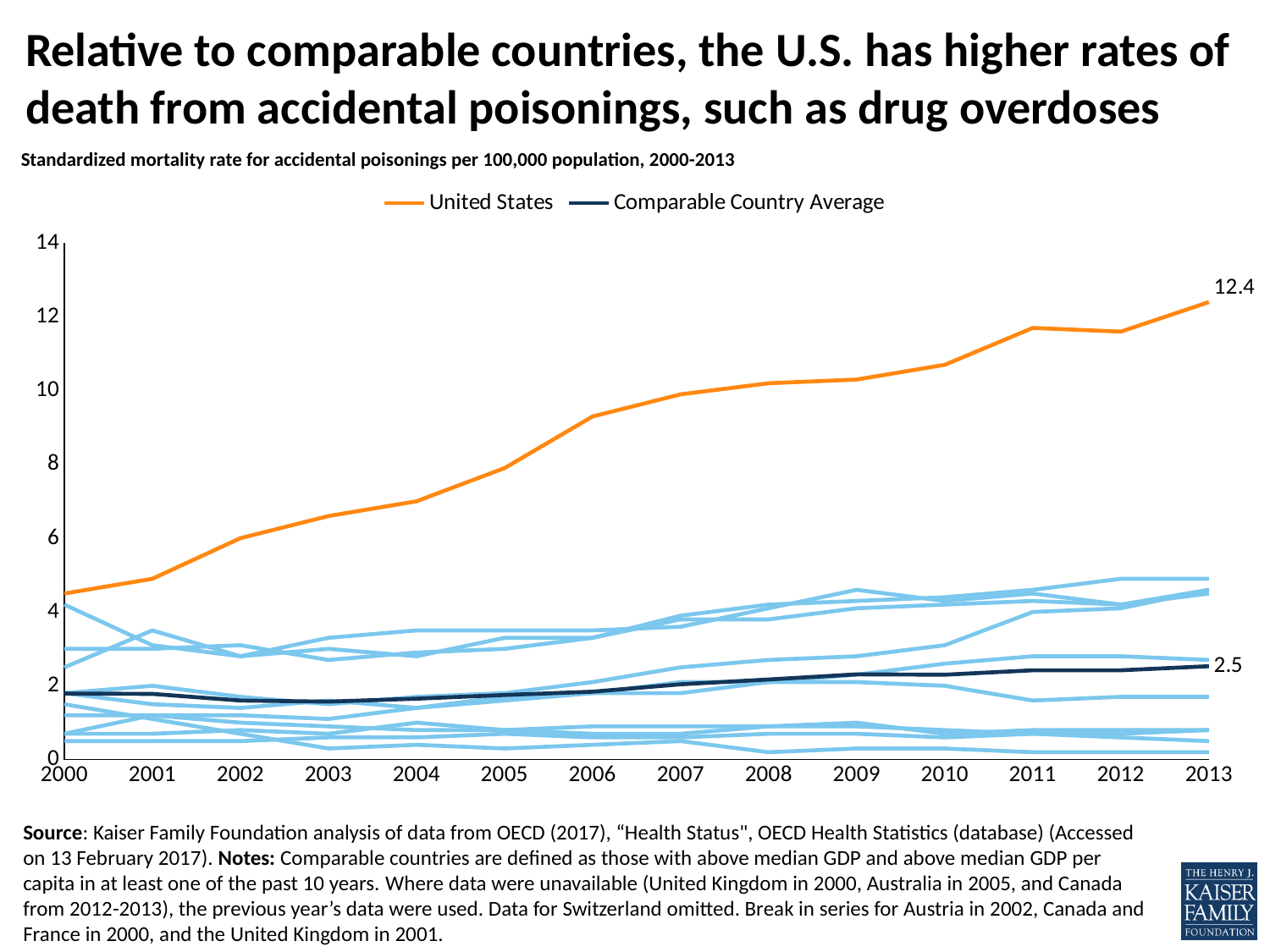
In 2013, which is larger: the United States value or the Comparable Country Average value? United States In which year is the United States value lowest? 2000 What is the value for the Comparable Country Average in 2013? 2.5 Is the value for the United States in 2006 greater or less than 8? greater In which year is the United States value highest? 2013 What kind of chart is shown on the slide? Line chart How many series does the legend list? 2 What is the difference between the United States and the Comparable Country Average values in 2013? 9.9 How many years are shown on the x axis? 14 Is the value for the United States in 2000 greater or less than 6? less Is the value for the United States in 2010 greater or less than 10? greater What is the value for the United States in 2013? 12.4